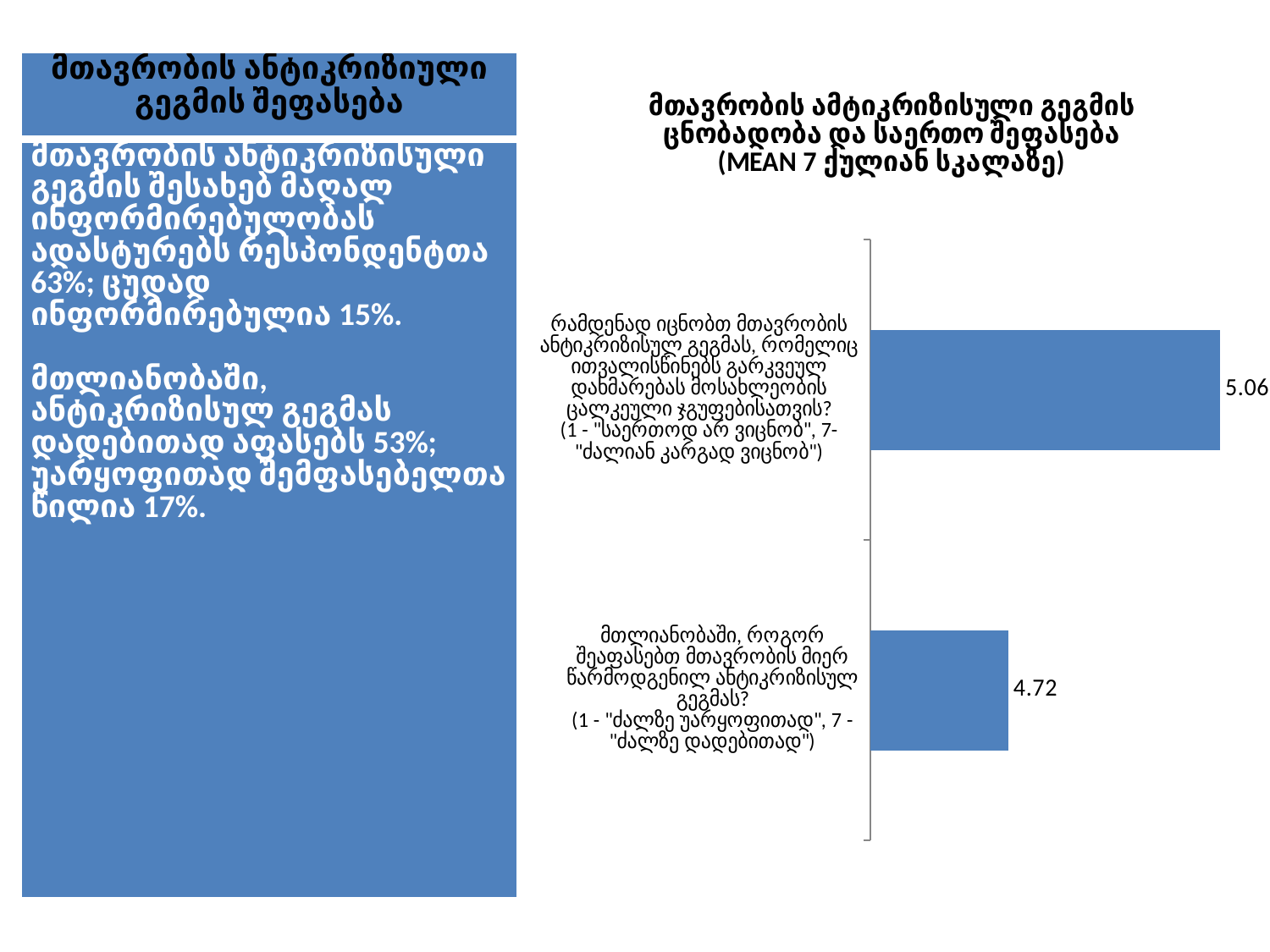
How many bars (categories) does the chart show? 2 What is the value of the bar for the question about how well respondents know the government's anti-crisis plan ("რამდენად იცნობთ მთავრობის ანტიკრიზისულ გეგმას...")? 5.06 What type of chart is shown on the slide? bar chart What is the title of the chart? მთავრობის ამტიკრიზისული გეგმის ცნობადობა და საერთო შეფასება (MEAN 7 ქულიან სკალაზე) What is the value of the bar for the question about how respondents evaluate the government's anti-crisis plan overall ("მთლიანობაში, როგორ შეაფასებთ...")? 4.72 What is the difference between the awareness score (5.06) and the overall evaluation score (4.72)? 0.34 Which is larger: the awareness score or the overall evaluation score? the awareness score (5.06) On what scale are the mean values in the chart measured, according to the chart title? 7-point scale (MEAN 7 ქულიან სკალაზე) Which category has the lowest value in the chart? მთლიანობაში, როგორ შეაფასებთ მთავრობის მიერ წარმოდგენილ ანტიკრიზისულ გეგმას (overall evaluation of the plan) Which category has the highest value in the chart? რამდენად იცნობთ მთავრობის ანტიკრიზისულ გეგმას (awareness of the plan)